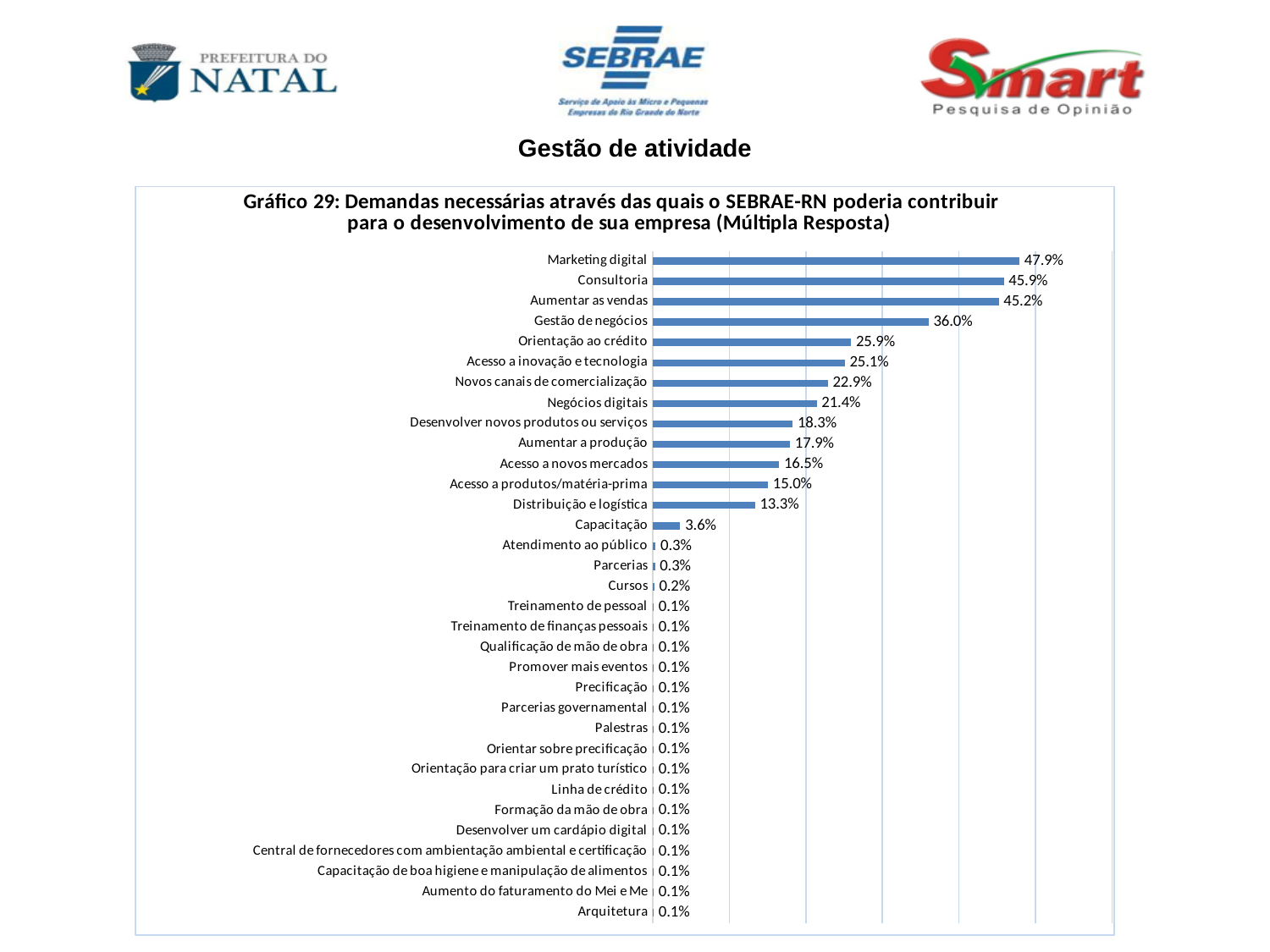
Which category has the highest value? Marketing digital What is the difference between Marketing digital and Gestão de negócios? 11.9% Which is larger, Orientação ao crédito or Negócios digitais? Orientação ao crédito What is the difference between Consultoria and Aumentar as vendas? 0.7% How many categories are shown in the chart? 33 What is the value for Distribuição e logística? 13.3% Which is larger, Acesso a novos mercados or Aumentar a produção? Aumentar a produção What kind of chart is shown on the slide? Bar chart What is the value for Gestão de negócios? 36.0% What is the value for Capacitação? 3.6% What is the number of the chart (Gráfico) shown in the title? 29 What is the value for Marketing digital? 47.9%